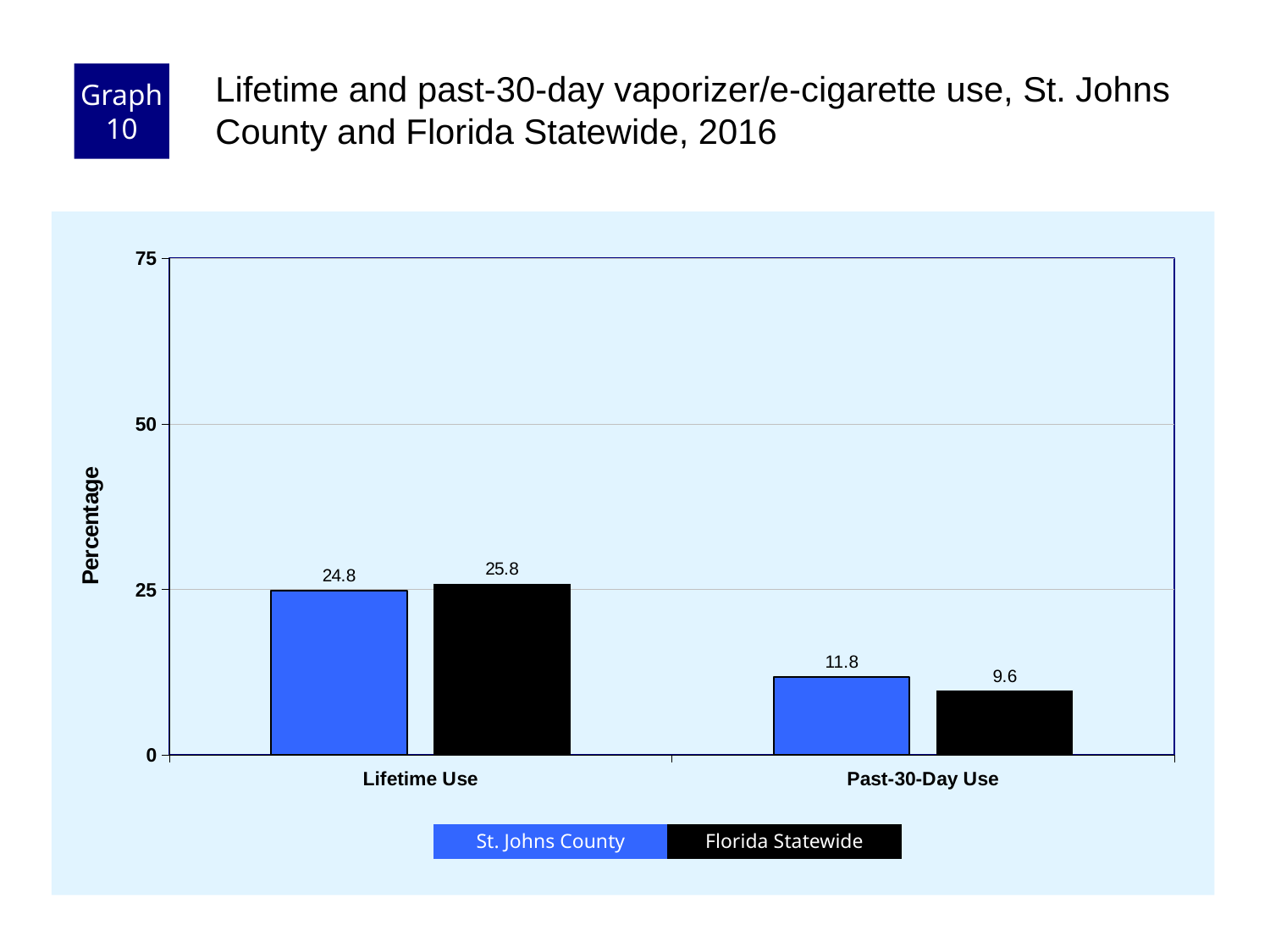
Which series has the highest value for Lifetime Use? Florida Statewide Which series has the lowest value for Past-30-Day Use? Florida Statewide What is the value for Florida Statewide for Lifetime Use? 25.8 Is the value for Florida Statewide for Lifetime Use greater or less than 25? greater What is the value for Florida Statewide for Past-30-Day Use? 9.6 What kind of chart is shown on the slide? Bar chart Which is larger for Past-30-Day Use: St. Johns County or Florida Statewide? St. Johns County What is the difference between the St. Johns County and Florida Statewide values for Past-30-Day Use? 2.2 What is the value for St. Johns County for Lifetime Use? 24.8 How many series does the legend list? 2 What is the value for St. Johns County for Past-30-Day Use? 11.8 What is the difference between the Florida Statewide and St. Johns County values for Lifetime Use? 1.0